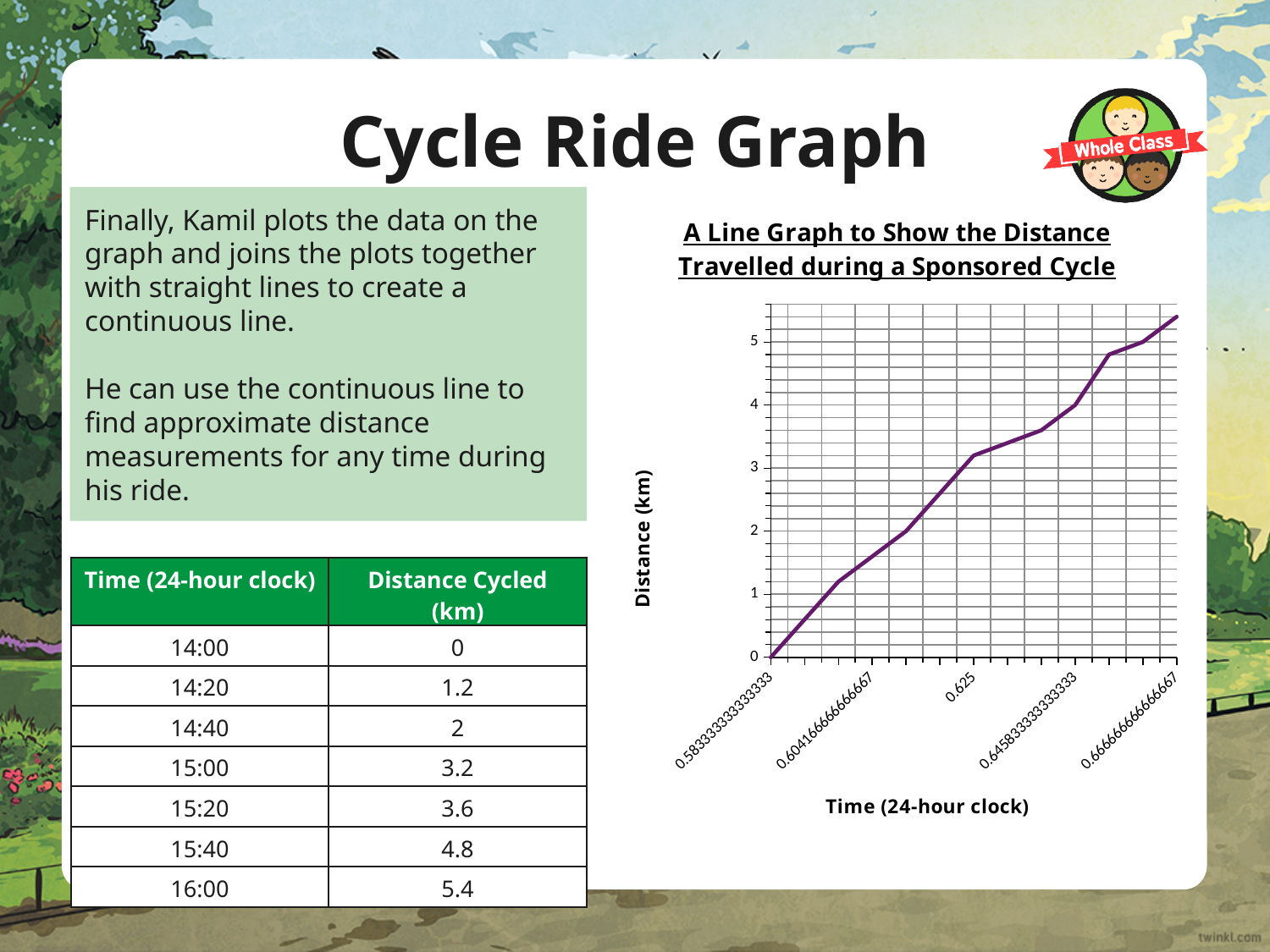
Is the plotted value at the x-axis label 0.645833333333333 greater or less than 5? less What is the plotted value at the first x-axis label, 0.583333333333333? 0 Is the plotted value at the x-axis label 0.625 greater or less than 4? less Is the plotted value at the x-axis label 0.604166666666667 greater or less than 2? less At which x-axis label is the plotted value highest? 0.666666666666667 What is the label on the vertical axis of the chart? Distance (km) How many labels are shown along the x axis of the chart? 5 What is the title of the chart? A Line Graph to Show the Distance Travelled during a Sponsored Cycle Do the values on the chart rise or fall as you move along the x axis? rise What kind of chart is shown on the slide? line chart